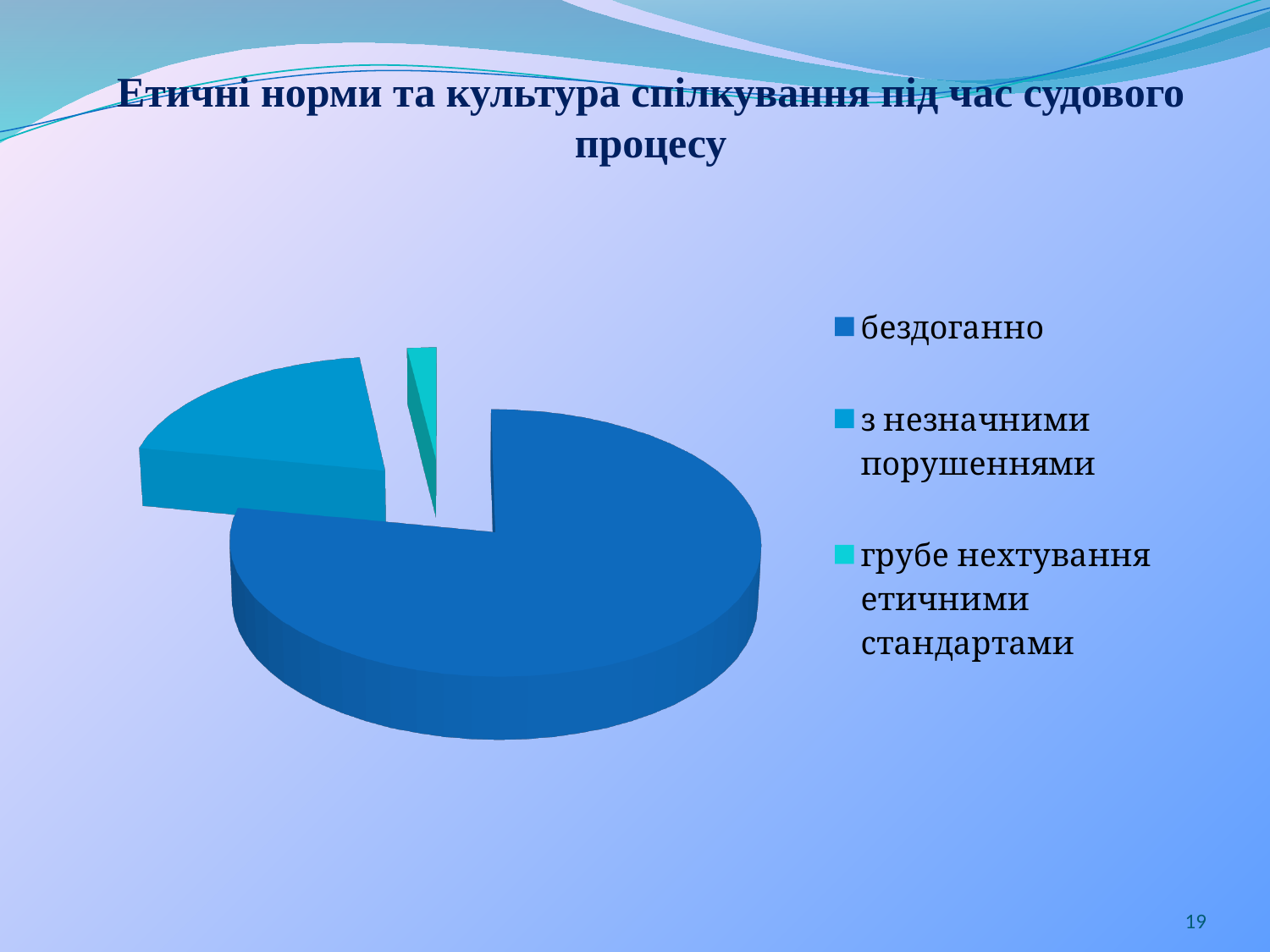
What kind of chart is shown on the slide? pie chart Which category has the smallest slice of the pie chart? грубе нехтування етичними стандартами How many slices does the pie chart have? 3 Which legend entry is shown in the lightest (turquoise) colour in the pie chart? грубе нехтування етичними стандартами Which slice is larger: "з незначними порушеннями" or "грубе нехтування етичними стандартами"? з незначними порушеннями What is the title of the slide containing the pie chart? Етичні норми та культура спілкування під час судового процесу Which slice is larger: "бездоганно" or "з незначними порушеннями"? бездоганно Which category has the largest slice of the pie chart? бездоганно How many entries does the legend of the pie chart list? 3